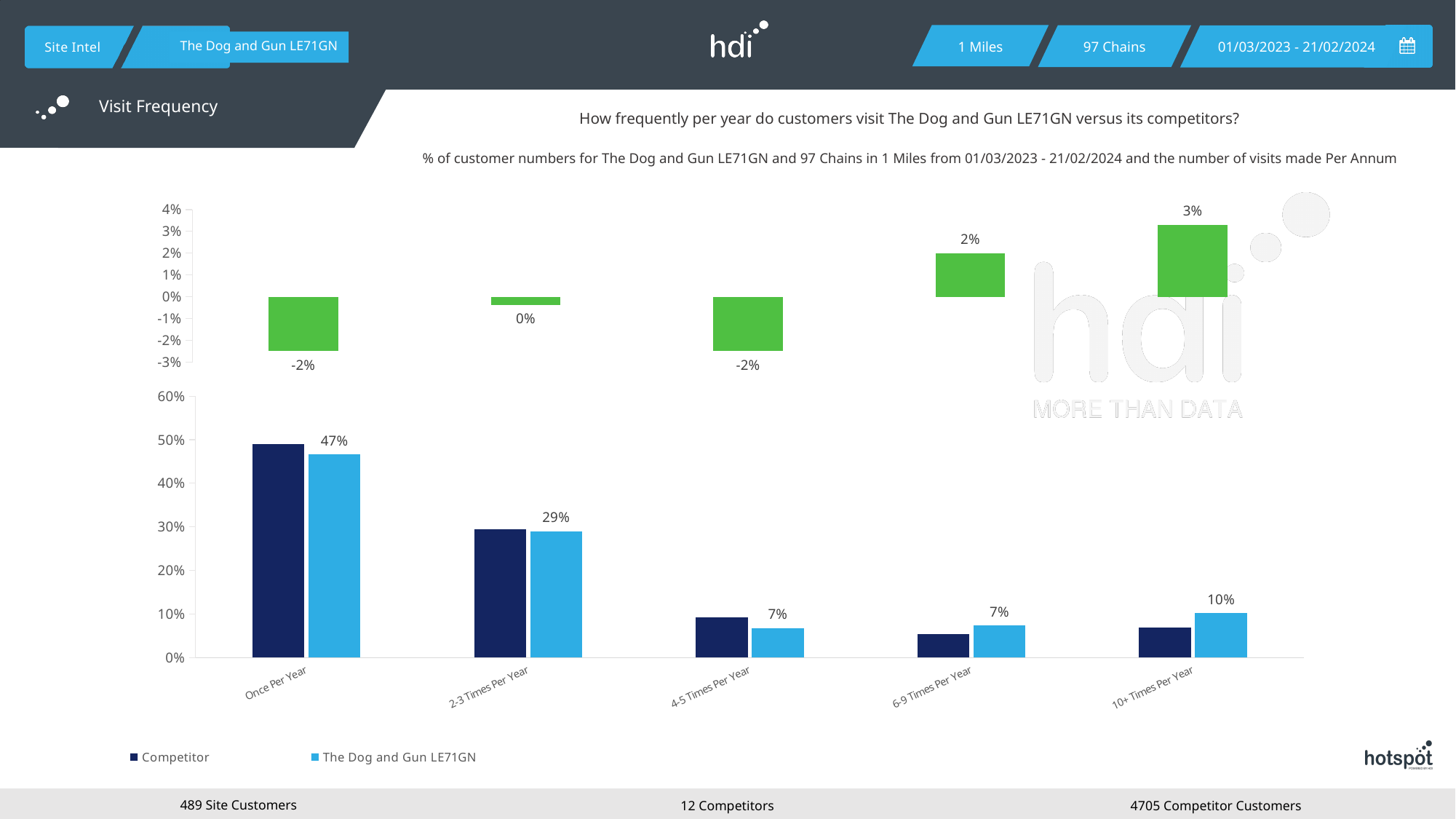
In the bottom bar chart, what percentage of The Dog and Gun LE71GN customers visit once per year? 47% In the bottom bar chart, what is the value for The Dog and Gun LE71GN for 10+ Times Per Year? 10% In the bottom bar chart, how many series does the legend list? 2 In the bottom bar chart, which visit frequency category has the highest value for The Dog and Gun LE71GN? Once Per Year In the top green chart, what is the value shown for 10+ Times Per Year? 3% In the bottom bar chart, how many visit frequency categories are shown on the x axis? 5 In the bottom bar chart, what is the difference between The Dog and Gun LE71GN values for Once Per Year and 2-3 Times Per Year? 18% What type of chart is the bottom chart? Bar chart In the bottom bar chart, what is the value for The Dog and Gun LE71GN for 2-3 Times Per Year? 29% In the top green chart, what is the value shown for Once Per Year? -2% In the bottom bar chart, for 10+ Times Per Year, which is larger: the Competitor bar or The Dog and Gun LE71GN bar? The Dog and Gun LE71GN In the bottom bar chart, is the Competitor value for Once Per Year greater or less than 40%? greater